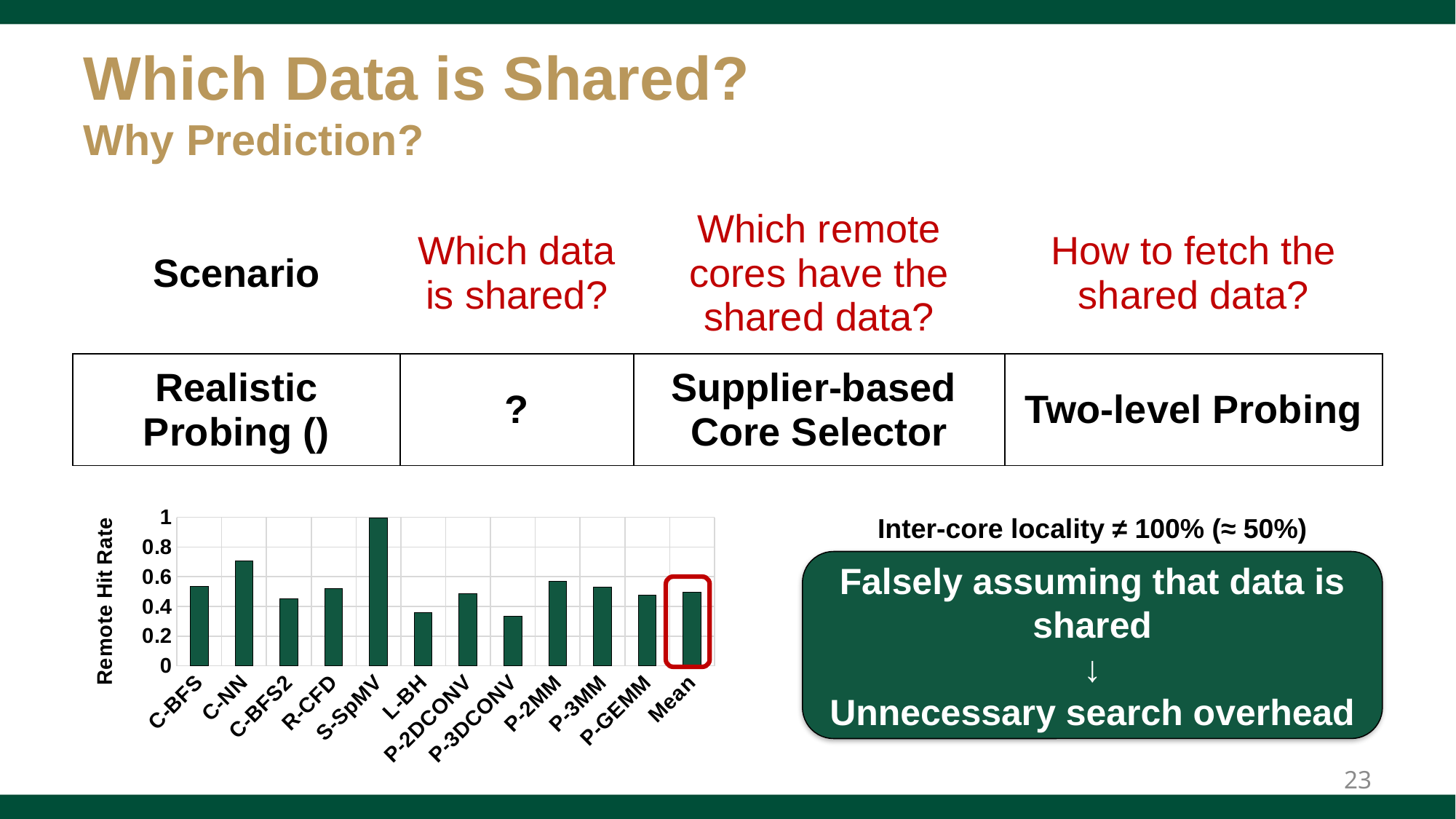
What is the label of the y axis of the chart? Remote Hit Rate Is the Remote Hit Rate for Mean greater or less than 0.6? less Is the Remote Hit Rate for C-NN greater or less than 0.8? less How many categories are shown on the x axis of the chart? 12 Is the Remote Hit Rate for P-3DCONV greater or less than 0.4? less What kind of chart is shown on the slide? bar chart Which has a higher Remote Hit Rate, P-3DCONV or S-SpMV? S-SpMV Which category has the highest Remote Hit Rate? S-SpMV Which has a higher Remote Hit Rate, C-NN or C-BFS? C-NN Which bar in the chart is outlined with a red box? Mean